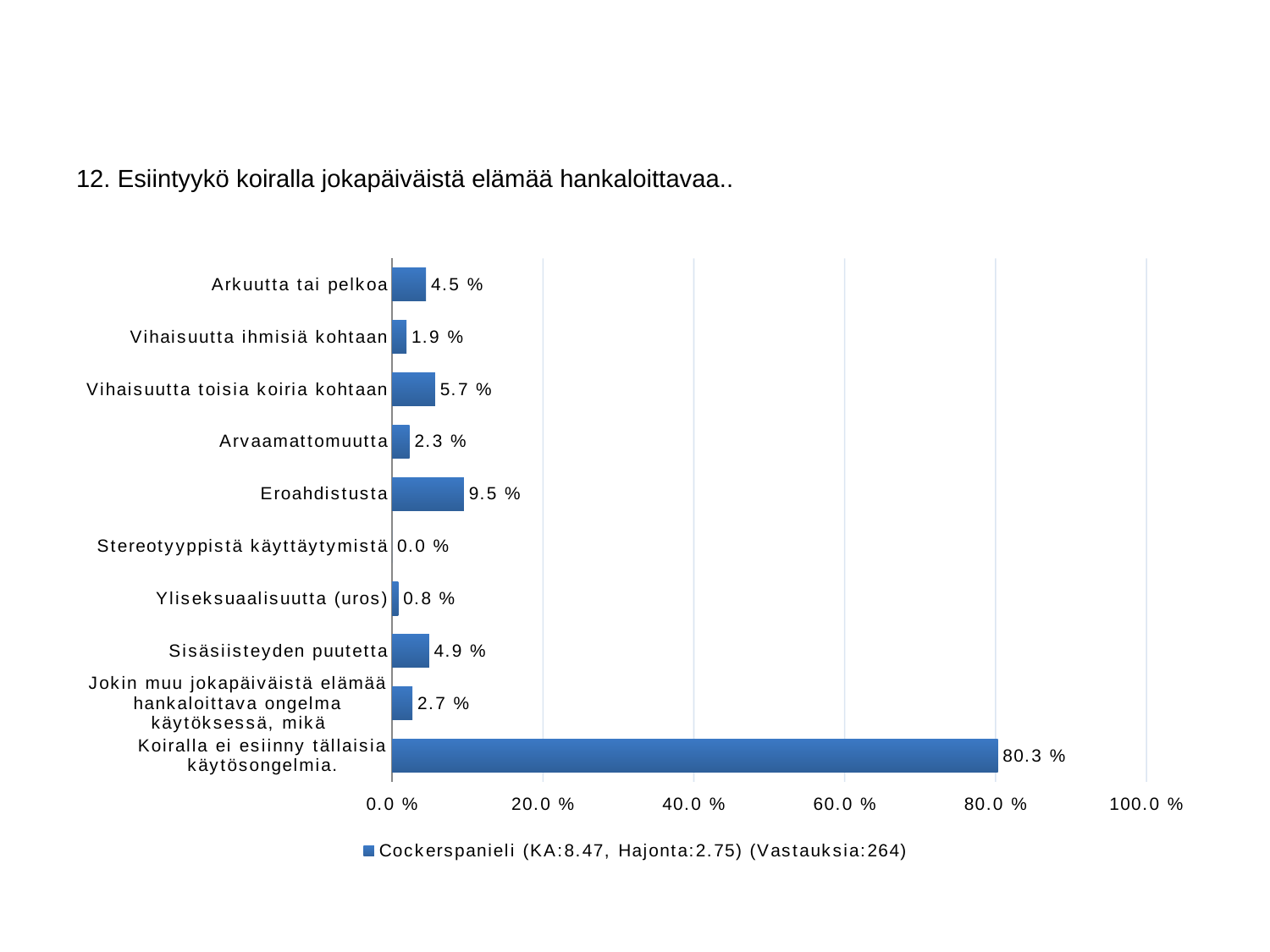
Which is larger, the value for Sisäsiisteyden puutetta or the value for Arvaamattomuutta? Sisäsiisteyden puutetta Which category has the highest value? Koiralla ei esiinny tällaisia käytösongelmia. What is the value for Vihaisuutta toisia koiria kohtaan? 5.7 % Which category has the lowest value? Stereotyyppistä käyttäytymistä What is the value for Eroahdistusta? 9.5 % What kind of chart is shown on the slide? bar chart What is the value for Koiralla ei esiinny tällaisia käytösongelmia.? 80.3 % How many series does the legend list? 1 How many responses (Vastauksia) does the legend entry report? 264 What is the difference between the values for Eroahdistusta and Arkuutta tai pelkoa? 5.0 % How many categories are shown on the chart? 10 Is the value for Koiralla ei esiinny tällaisia käytösongelmia. greater or less than 60.0 %? greater